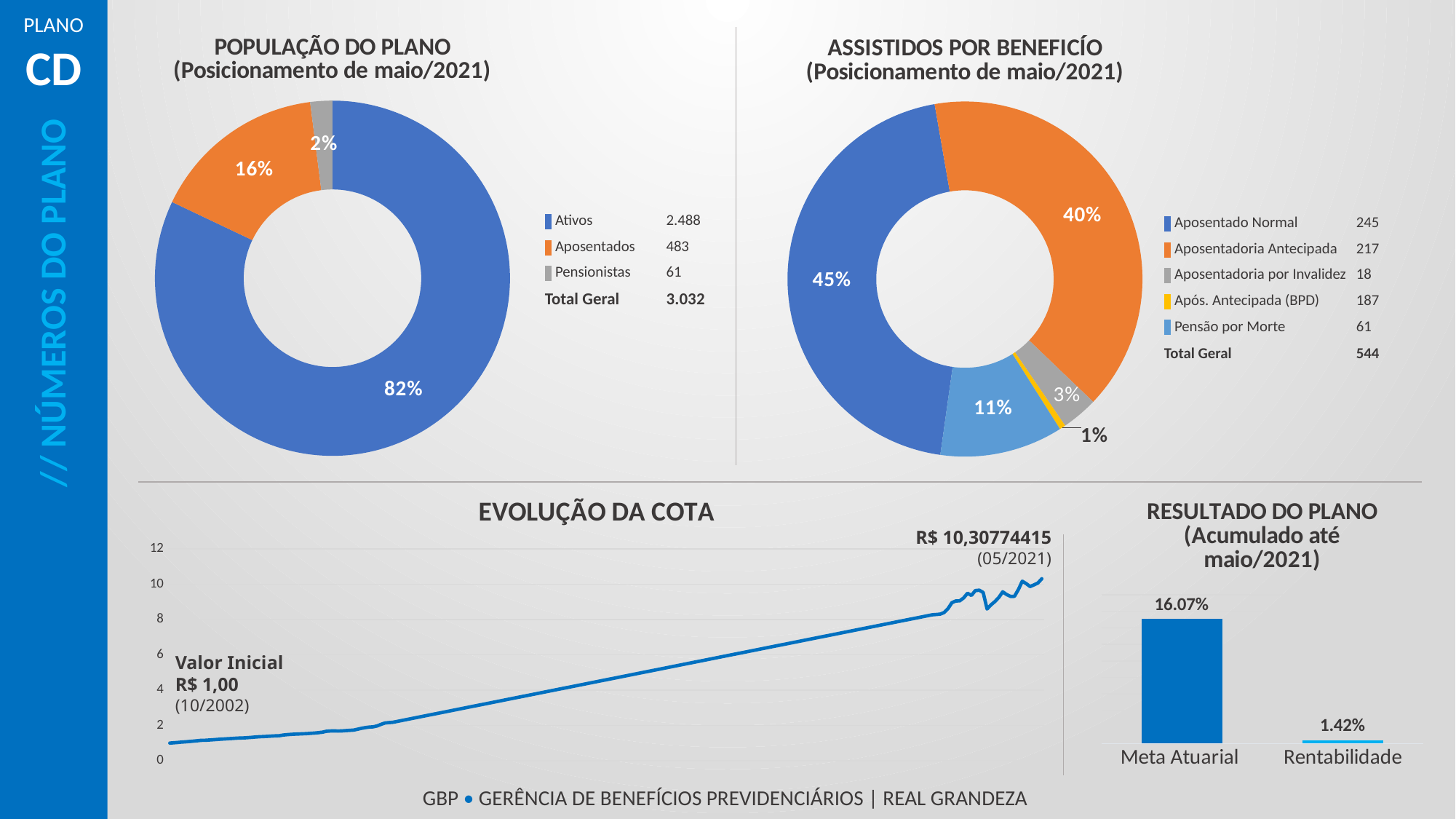
In the POPULAÇÃO DO PLANO chart, which category has the smallest value? Pensionistas In the POPULAÇÃO DO PLANO chart, what is the Total Geral? 3.032 In the ASSISTIDOS POR BENEFICÍO chart, which category has the largest value? Aposentado Normal In the EVOLUÇÃO DA COTA chart, does the value rise or fall over time? Rise In the RESULTADO DO PLANO chart, which is larger, Meta Atuarial or Rentabilidade? Meta Atuarial What type of chart is EVOLUÇÃO DA COTA? Line chart In the POPULAÇÃO DO PLANO chart, what is the value for Ativos? 2.488 How many categories does the legend of the ASSISTIDOS POR BENEFICÍO chart list (excluding Total Geral)? 5 In the POPULAÇÃO DO PLANO chart, what share of the donut does Aposentados represent? 16% In the ASSISTIDOS POR BENEFICÍO chart, what is the difference between Aposentado Normal and Pensão por Morte? 184 In the EVOLUÇÃO DA COTA chart, what is the value shown for 05/2021? R$ 10,30774415 In the ASSISTIDOS POR BENEFICÍO chart, what is the value for Aposentadoria Antecipada? 217